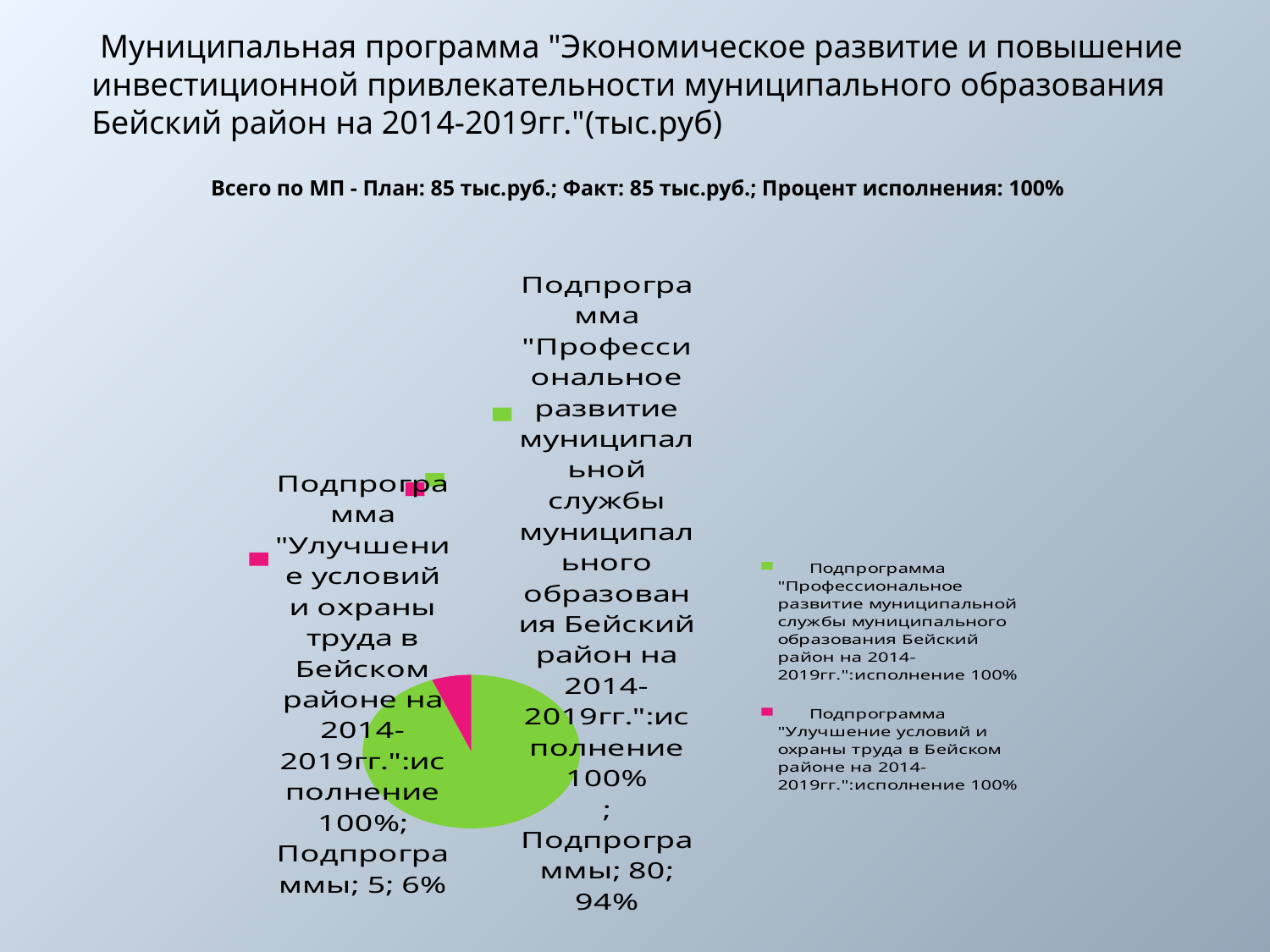
What colour is the slice for the subprogram "Улучшение условий и охраны труда"? pink How many entries does the legend of the pie chart list? 2 Which subprogram has the largest slice in the pie chart? Подпрограмма "Профессиональное развитие муниципальной службы муниципального образования Бейский район на 2014-2019гг." What kind of chart is shown on the slide? pie chart What is the value shown for the subprogram "Профессиональное развитие муниципальной службы" in the pie chart? 80 How many slices does the pie chart have? 2 What is the value shown for the subprogram "Улучшение условий и охраны труда в Бейском районе" in the pie chart? 5 What share of the pie does the subprogram "Улучшение условий и охраны труда" take? 6% Which is larger: the value for "Профессиональное развитие муниципальной службы" or the value for "Улучшение условий и охраны труда"? Профессиональное развитие муниципальной службы Which subprogram has the smallest slice in the pie chart? Подпрограмма "Улучшение условий и охраны труда в Бейском районе на 2014-2019гг." What is the difference between the values of the two slices in the pie chart? 75 What share of the pie does the subprogram "Профессиональное развитие муниципальной службы" take? 94%